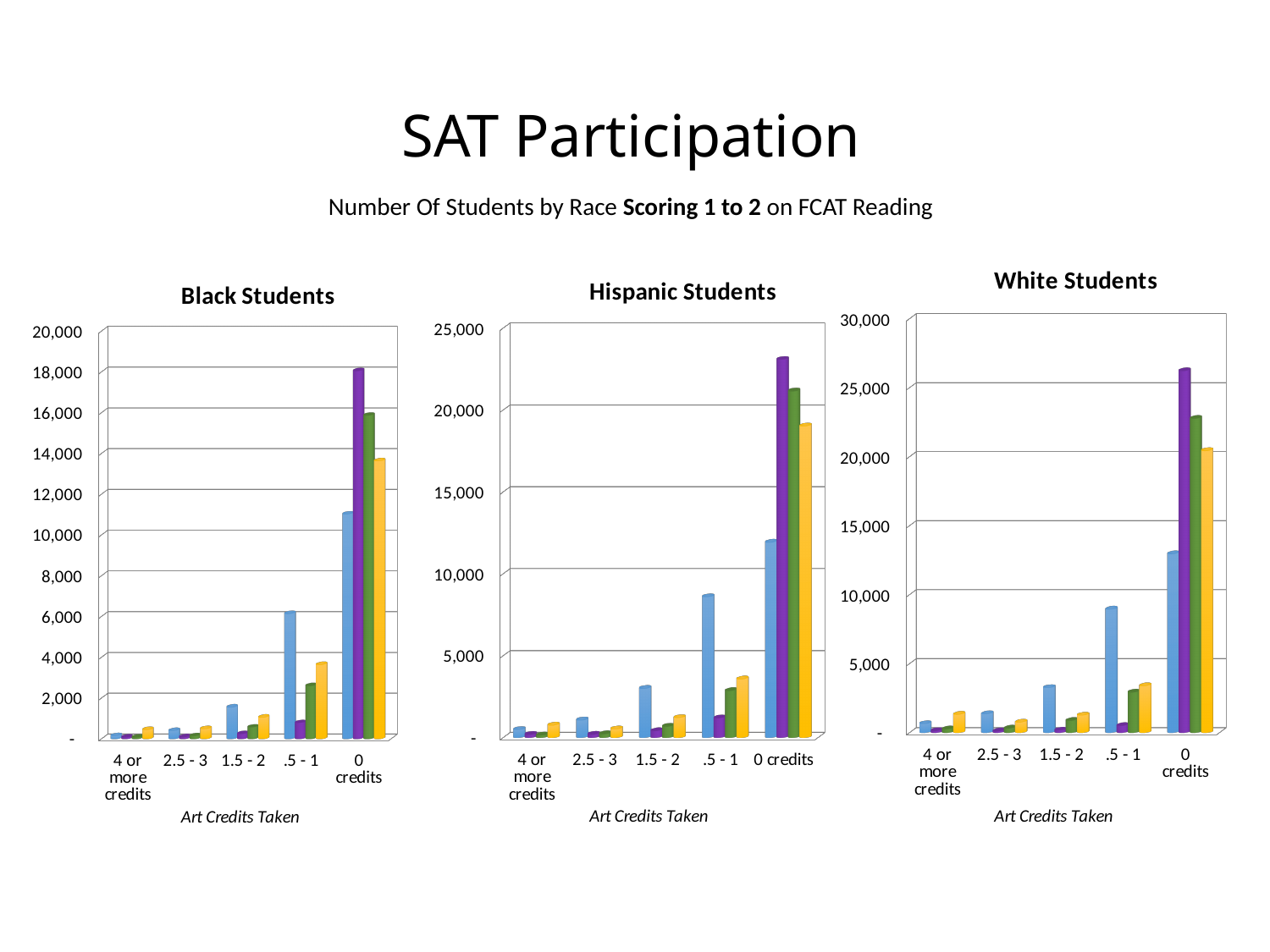
What is the highest value shown on the y axis of the White Students chart? 30,000 In the Hispanic Students chart, which category has the lowest blue bar? 4 or more credits In the Black Students chart, is the value of the purple bar for 0 credits greater or less than 16,000? greater In the White Students chart, is the value of the purple bar for 0 credits greater or less than 20,000? greater How many categories are on the x axis of the Hispanic Students chart? 5 In the Black Students chart, do the blue bars rise or fall moving from left to right along the x axis? rise In the Black Students chart, for 0 credits, which is larger: the blue bar or the purple bar? the purple bar In the Hispanic Students chart, is the value of the blue bar for .5 - 1 credits greater or less than 5,000? greater How many charts are shown on the slide? 3 What is the x-axis title of the White Students chart? Art Credits Taken In the Black Students chart, which category has the tallest bars? 0 credits What kind of chart is the Black Students chart? bar chart